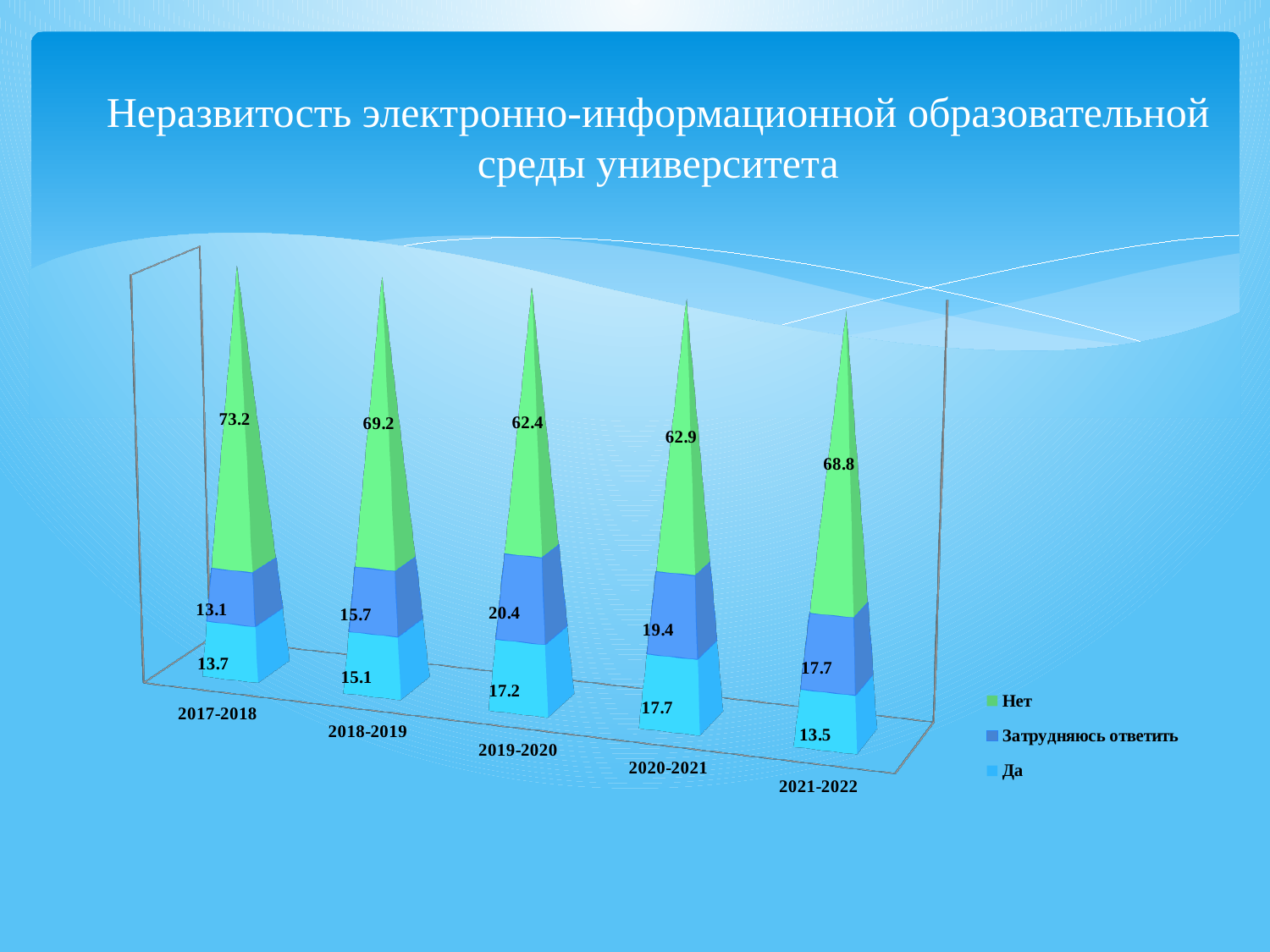
Which series is shown in green in the legend? Нет How many academic years are shown on the x axis? 5 What is the value for "Нет" in 2017-2018? 73.2 What kind of chart is shown on the slide? Stacked bar chart What is the value for "Да" in 2019-2020? 17.2 What is the difference between the "Нет" values for 2017-2018 and 2019-2020? 10.8 In which academic year is the value for "Затрудняюсь ответить" the lowest? 2017-2018 In which academic year is the value for "Нет" the highest? 2017-2018 What is the total of the stacked bar for 2018-2019? 100.0 What is the value for "Затрудняюсь ответить" in 2021-2022? 17.7 Which is larger: the "Да" value for 2020-2021 or for 2021-2022? 2020-2021 How many series does the legend list? 3